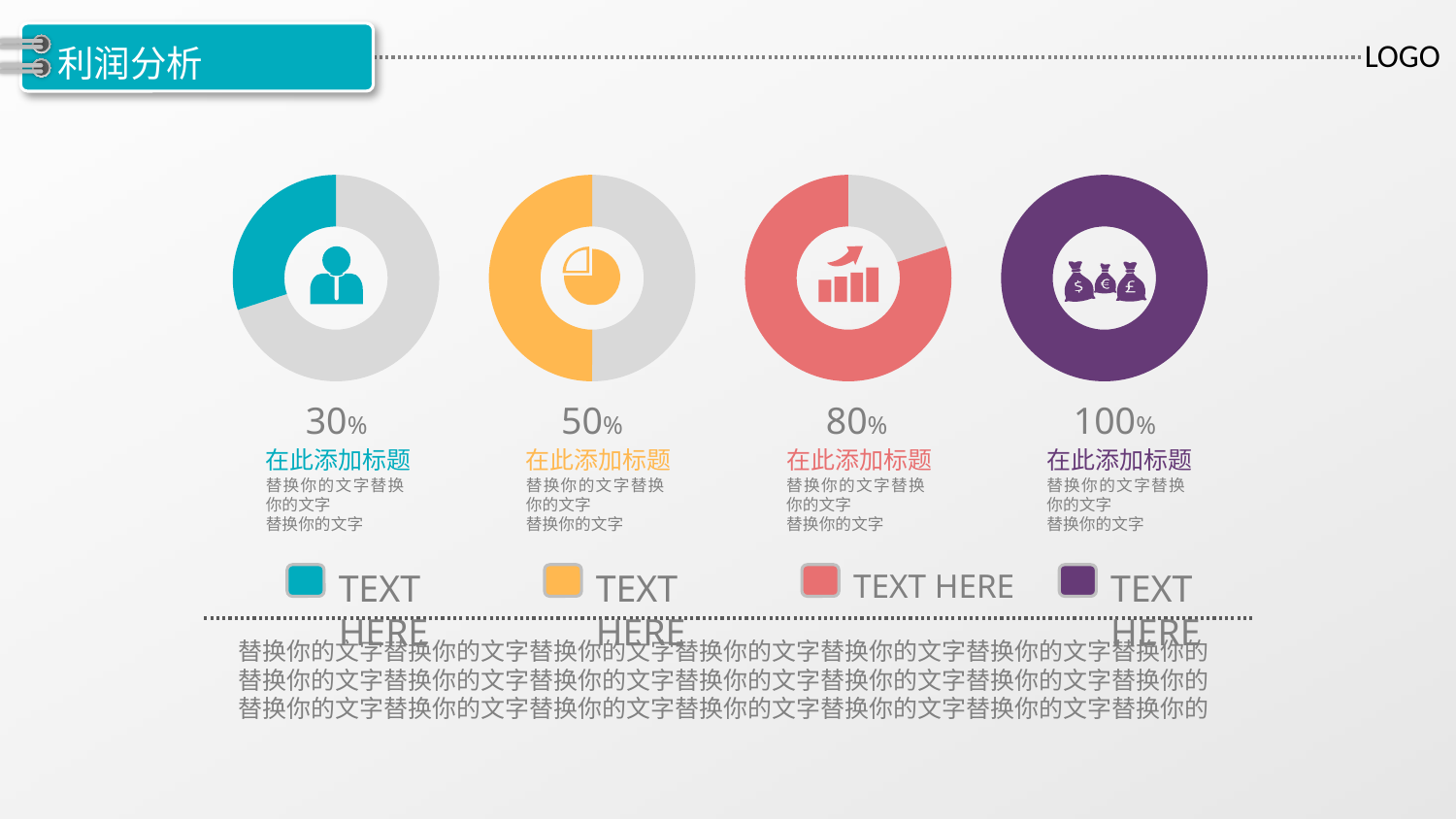
Which shows a larger percentage, the orange donut chart or the red donut chart? The red donut chart Which of the four donut charts shows the highest percentage? The rightmost (purple) chart, 100% What percentage is shown below the leftmost (teal) donut chart? 30% Do the percentages increase or decrease from the leftmost chart to the rightmost chart? Increase What is the difference between the percentage of the purple donut chart and the orange donut chart? 50% How many donut charts are on the slide? 4 What kind of chart is used to display the percentages on this slide? Donut (pie) chart What percentage is shown below the rightmost (purple) donut chart? 100% What percentage is shown below the third (red) donut chart? 80% Which of the four donut charts shows the lowest percentage? The leftmost (teal) chart, 30% What is the difference between the percentage of the red donut chart and the teal donut chart? 50% What percentage is shown below the second (orange) donut chart? 50%